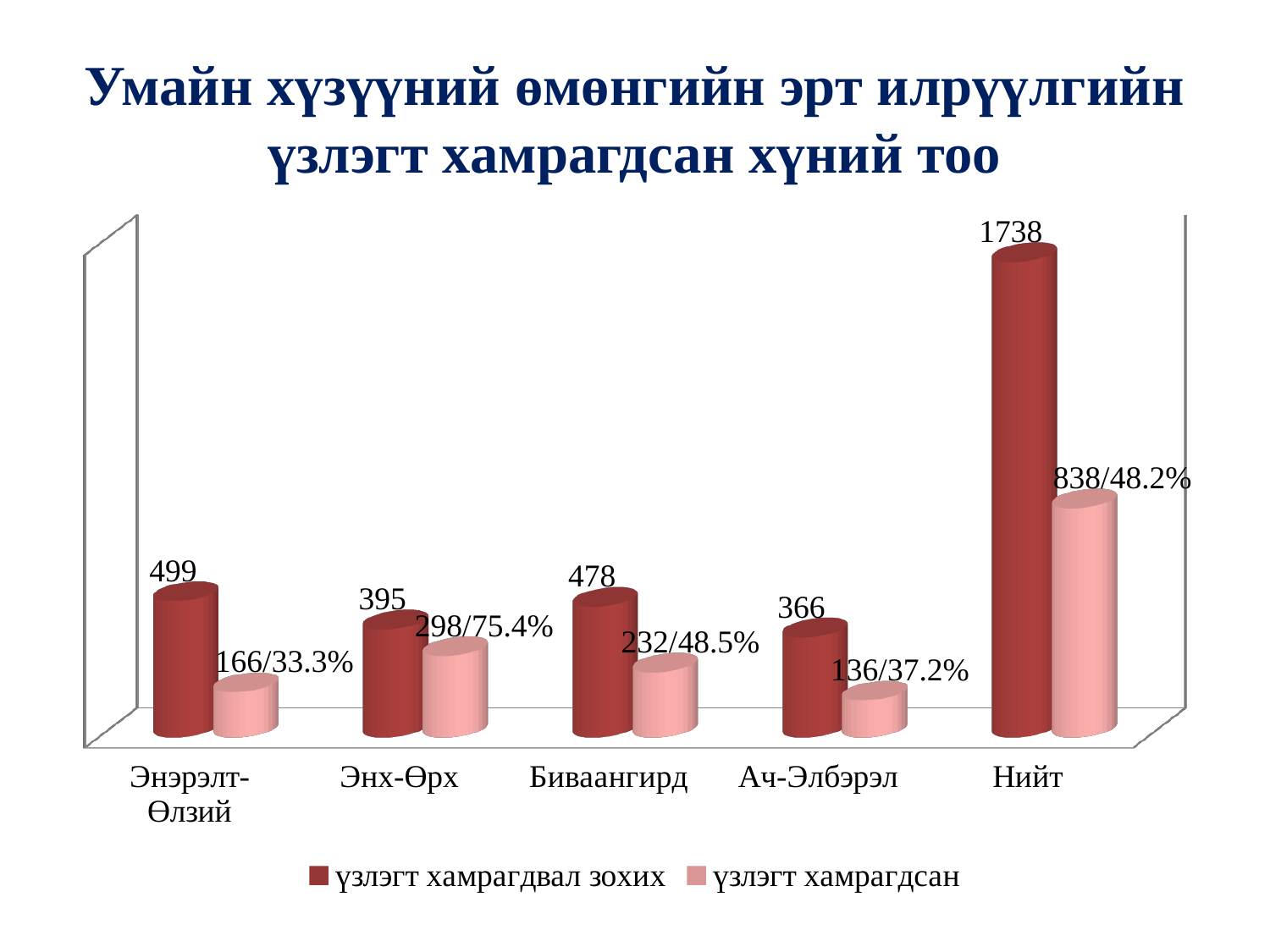
What data label is shown for "үзлэгт хамрагдсан" for Ач-Элбэрэл? 136/37.2% How many categories are shown on the x axis? 5 What is the difference between "үзлэгт хамрагдвал зохих" and "үзлэгт хамрагдсан" for Энэрэлт-Өлзий? 333 Excluding Нийт, which category has the highest "үзлэгт хамрагдсан" count? Энх-Өрх How many series does the legend list? 2 What kind of chart is shown on the slide? Bar chart What is the value of "үзлэгт хамрагдвал зохих" for Энэрэлт-Өлзий? 499 What is the value of "үзлэгт хамрагдвал зохих" for Биваангирд? 478 Which category has the lowest value for "үзлэгт хамрагдвал зохих"? Ач-Элбэрэл What is the value of "үзлэгт хамрагдвал зохих" for Нийт? 1738 What data label is shown for "үзлэгт хамрагдсан" for Энх-Өрх? 298/75.4% Which is larger: "үзлэгт хамрагдвал зохих" for Энх-Өрх or for Биваангирд? Биваангирд